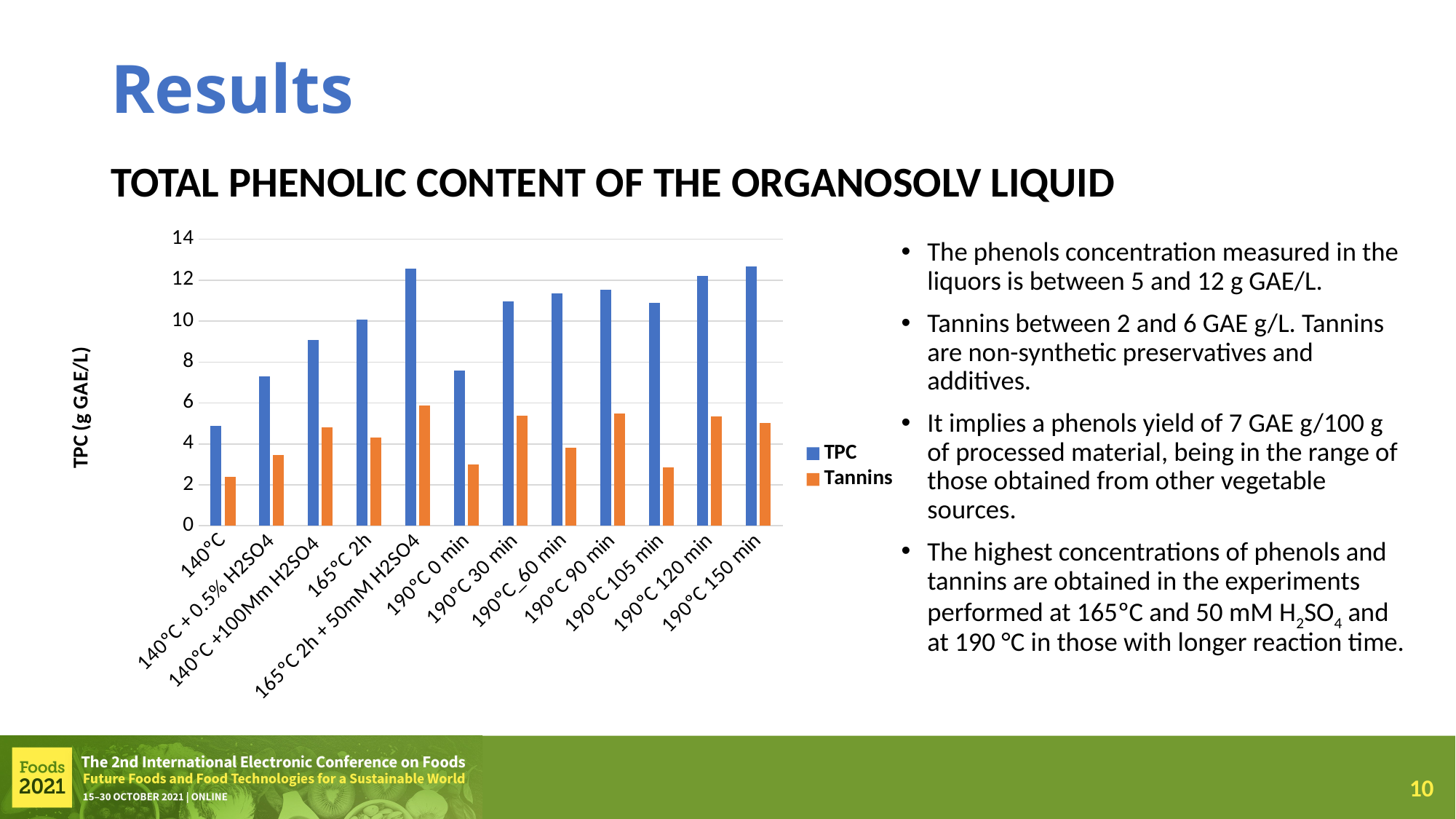
How many series does the legend list? 2 How many categories are shown on the x axis of the chart? 12 Which has the larger Tannins value, 190°C 0 min or 190°C 90 min? 190°C 90 min Is the TPC value for 140°C greater or less than 6? less Which category has the lowest TPC value? 140°C Which category has the highest Tannins value? 165°C 2h + 50mM H2SO4 Is the Tannins value for 140°C greater or less than 4? less Is the TPC value for 165°C 2h + 50mM H2SO4 greater or less than 12? greater What kind of chart is shown on the slide? bar chart What is the label on the y axis of the chart? TPC (g GAE/L) Which has the larger TPC value, 140°C or 165°C 2h? 165°C 2h